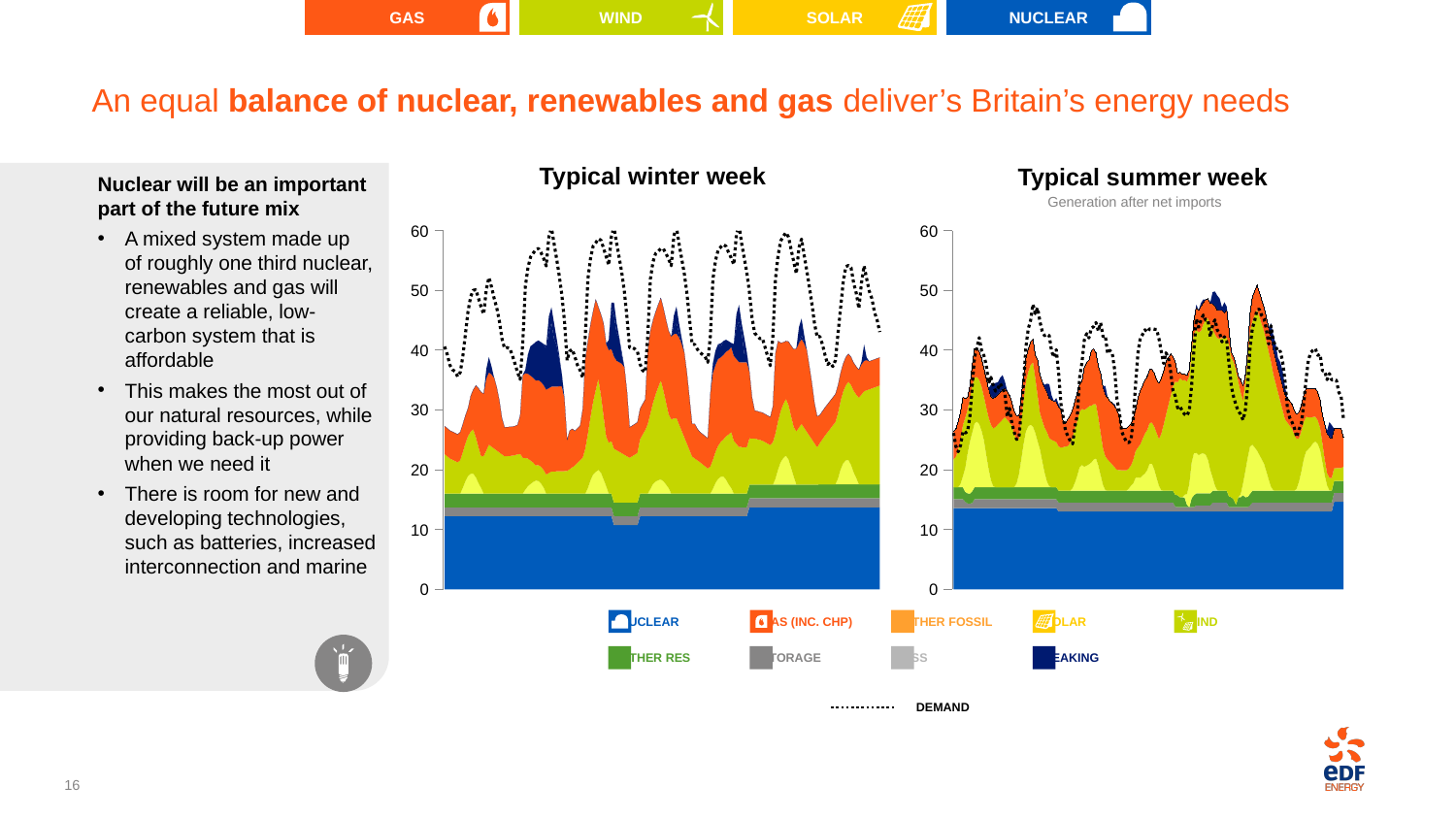
How many charts are shown on the slide? 2 What is the subtitle shown under the "Typical summer week" chart title? Generation after net imports In the "Typical summer week" chart, is the peak of the demand line greater or less than 40? greater In the "Typical winter week" chart, is the lowest point of the demand line greater or less than 30? greater What is the highest value shown on the y axis of the "Typical summer week" chart? 60 What does the dotted black line in the charts represent, according to the legend? DEMAND In the "Typical winter week" chart, is the bottom (dark blue) layer of the stack greater or less than 20? less Which chart shows the higher peak demand, "Typical winter week" or "Typical summer week"? Typical winter week What kind of chart is the "Typical winter week" chart? Stacked area chart